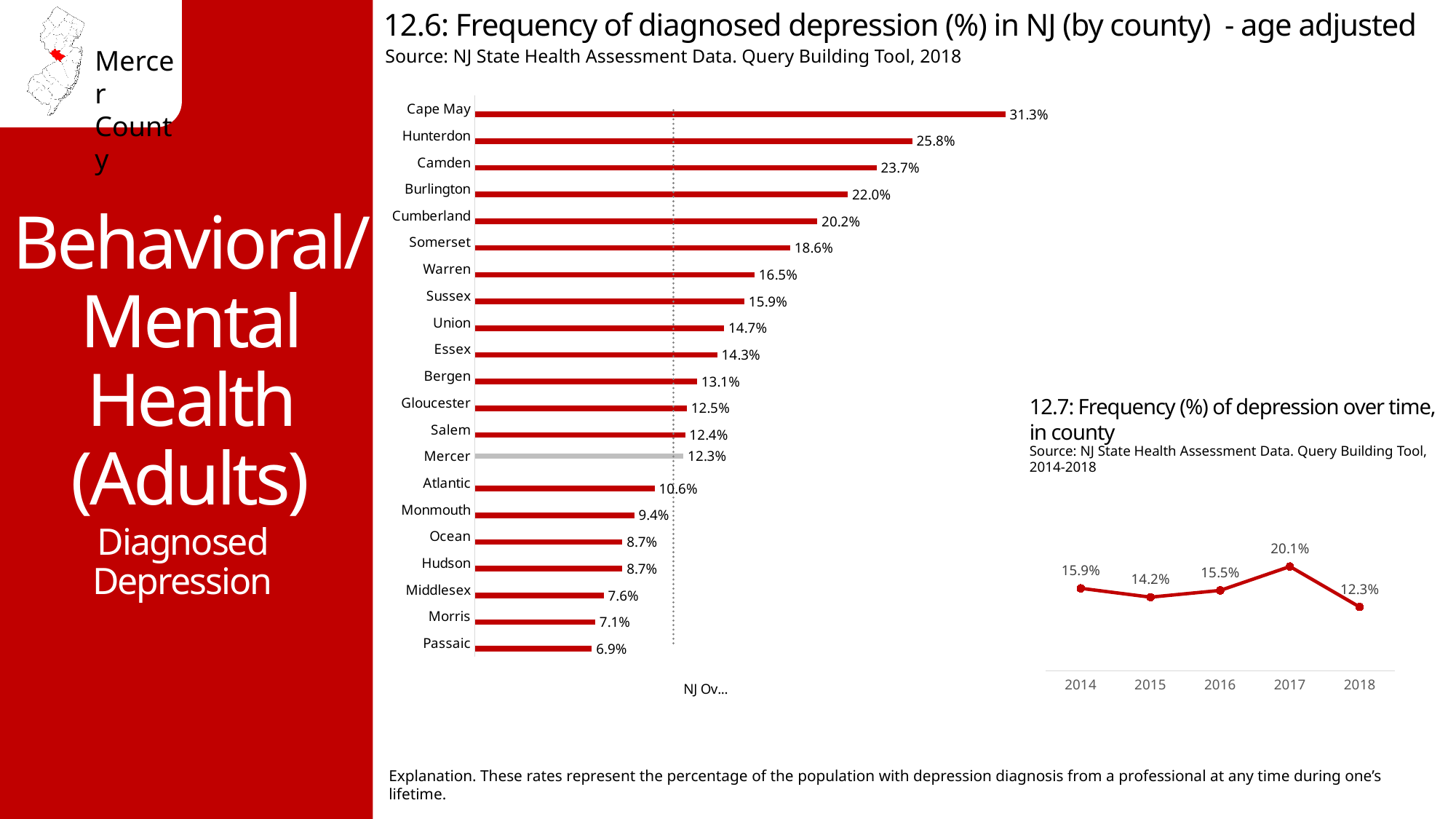
How many counties are shown in the chart '12.6: Frequency of diagnosed depression (%) in NJ (by county) - age adjusted'? 21 In the chart '12.7: Frequency (%) of depression over time, in county', what is the value for 2017? 20.1% In the chart '12.6: Frequency of diagnosed depression (%) in NJ (by county) - age adjusted', which county has the lowest value? Passaic In the chart '12.6: Frequency of diagnosed depression (%) in NJ (by county) - age adjusted', what is the value for Mercer? 12.3% What kind of chart is '12.6: Frequency of diagnosed depression (%) in NJ (by county) - age adjusted'? Bar chart In the chart '12.6: Frequency of diagnosed depression (%) in NJ (by county) - age adjusted', which is larger, Somerset or Warren? Somerset In the chart '12.6: Frequency of diagnosed depression (%) in NJ (by county) - age adjusted', what is the value for Cape May? 31.3% How many data points are plotted in the chart '12.7: Frequency (%) of depression over time, in county'? 5 In the chart '12.6: Frequency of diagnosed depression (%) in NJ (by county) - age adjusted', which county has the highest value? Cape May In the chart '12.6: Frequency of diagnosed depression (%) in NJ (by county) - age adjusted', what is the difference between Hunterdon and Camden? 2.1% In the chart '12.7: Frequency (%) of depression over time, in county', which year has the lowest value? 2018 In the chart '12.7: Frequency (%) of depression over time, in county', what is the difference between 2017 and 2018? 7.8%